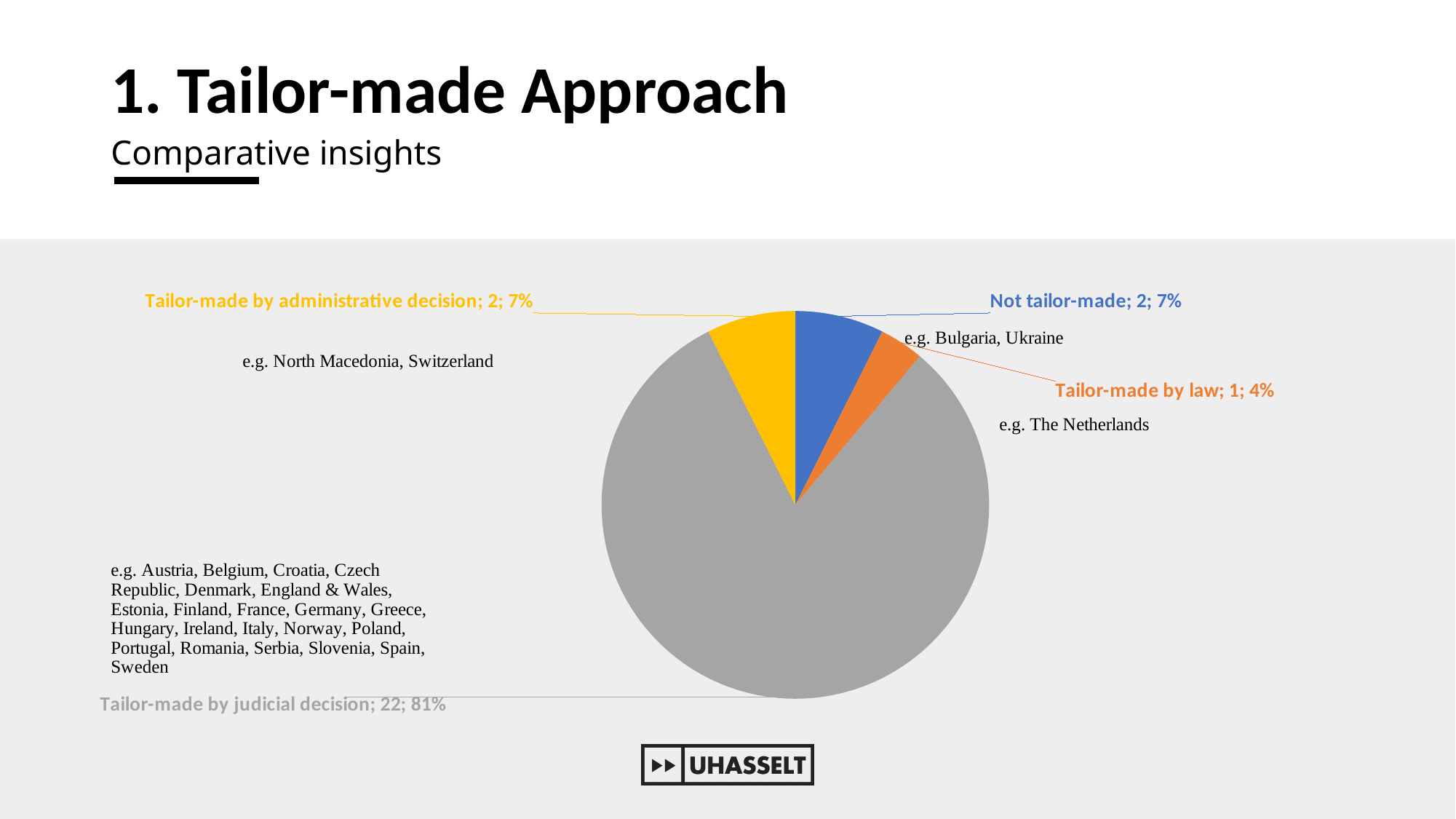
Which category has the largest slice? Tailor-made by judicial decision How many slices does the pie chart have? 4 What kind of chart is shown on the slide? Pie chart What percentage share does 'Not tailor-made' have? 7% What percentage share does 'Tailor-made by judicial decision' have? 81% What is the count for 'Tailor-made by judicial decision'? 22 Which is larger: the count for 'Not tailor-made' or the count for 'Tailor-made by law'? Not tailor-made What is the count for 'Tailor-made by law'? 1 Which category has the smallest slice? Tailor-made by law What is the difference in count between 'Tailor-made by judicial decision' and 'Tailor-made by administrative decision'? 20 What colour is the 'Tailor-made by administrative decision' slice? Yellow Which countries are given as examples for 'Not tailor-made'? Bulgaria, Ukraine